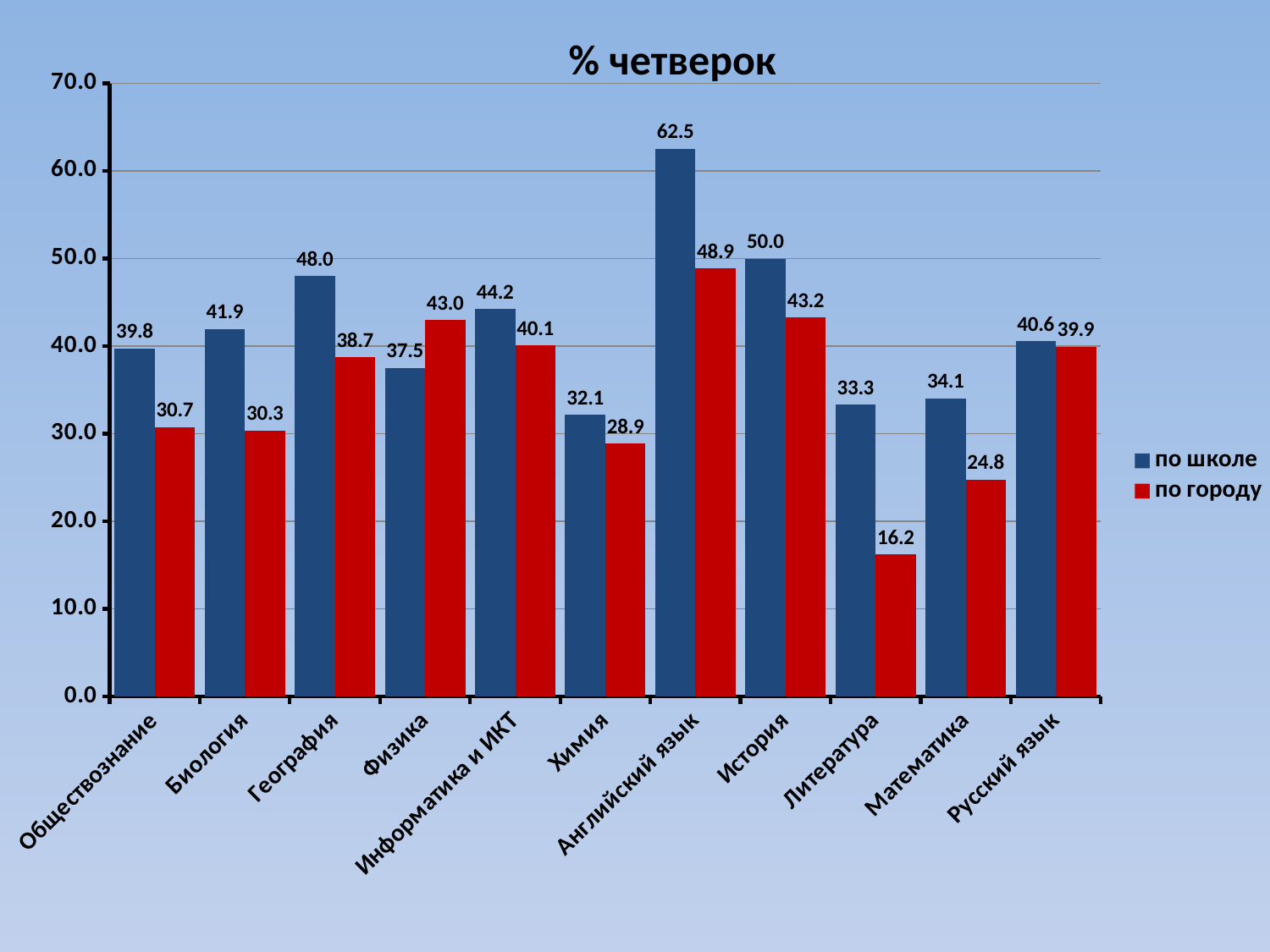
Which category has the highest value in the по школе series? Английский язык What kind of chart is shown on the slide? bar chart Is the по школе value for История greater or less than 40.0? greater Which category has the lowest value in the по городу series? Литература How many categories are shown on the x axis? 11 What is the difference between the по школе and по городу values for Английский язык? 13.6 What is the value for Литература in the по городу series? 16.2 How many series does the legend list? 2 What is the title of the chart? % четверок What is the value for Английский язык in the по школе series? 62.5 For Физика, which series has the larger value, по школе or по городу? по городу What is the value for Физика in the по городу series? 43.0